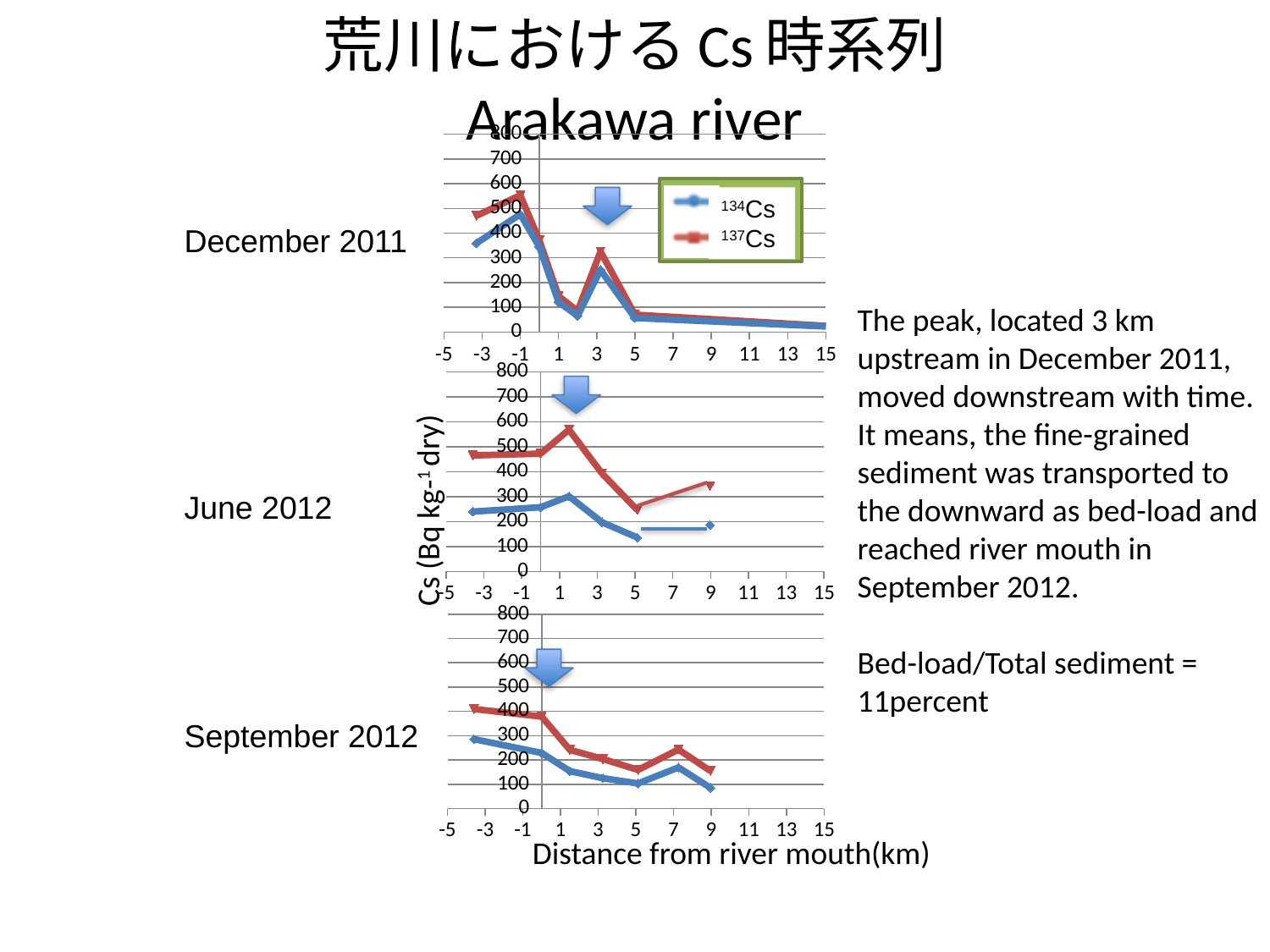
In the September 2012 chart, is the 137Cs value at -3 km greater or less than 300? greater In the September 2012 chart, is the 134Cs value at 5 km greater or less than 200? less In the June 2012 chart, is the peak value of 137Cs greater or less than 500? greater How many series does the legend list? 2 What kind of chart is used for the December 2011 panel? line chart How many separate chart panels (time points) are shown on the slide? 3 In the December 2011 chart, does the 137Cs value rise or fall between 5 km and 15 km? fall In the December 2011 chart, at which distance from the river mouth does 137Cs reach its highest value? -1 km What is the label of the x axis? Distance from river mouth(km) In the June 2012 chart, which series has the higher value at 1 km, 134Cs or 137Cs? 137Cs Which two series are listed in the legend? 134Cs and 137Cs